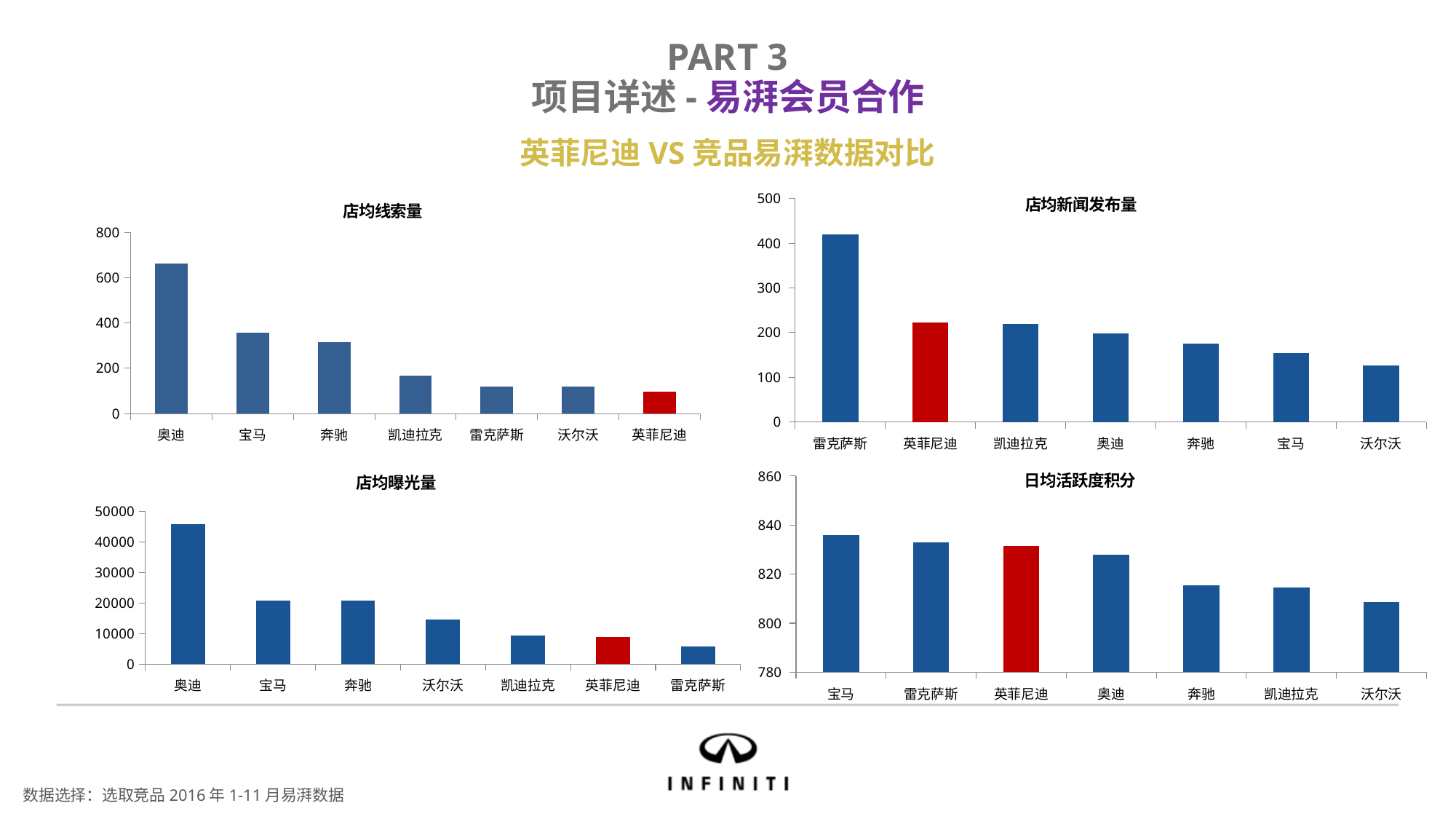
In the 店均线索量 chart, is the value for 奥迪 greater or less than 600? greater In the 店均新闻发布量 chart, is the value for 雷克萨斯 greater or less than 400? greater What kind of chart is the 日均活跃度积分 chart? bar chart In the 店均新闻发布量 chart, which category has the highest value? 雷克萨斯 In the 店均曝光量 chart, which is larger, the value for 沃尔沃 or the value for 凯迪拉克? 沃尔沃 In the 店均新闻发布量 chart, which category has the lowest value? 沃尔沃 In the 店均曝光量 chart, which category has the lowest value? 雷克萨斯 How many categories are shown in the 店均线索量 chart? 7 In the 店均曝光量 chart, is the value for 奥迪 greater or less than 40000? greater In the 日均活跃度积分 chart, which category has the lowest value? 沃尔沃 In the 店均线索量 chart, which category has the highest value? 奥迪